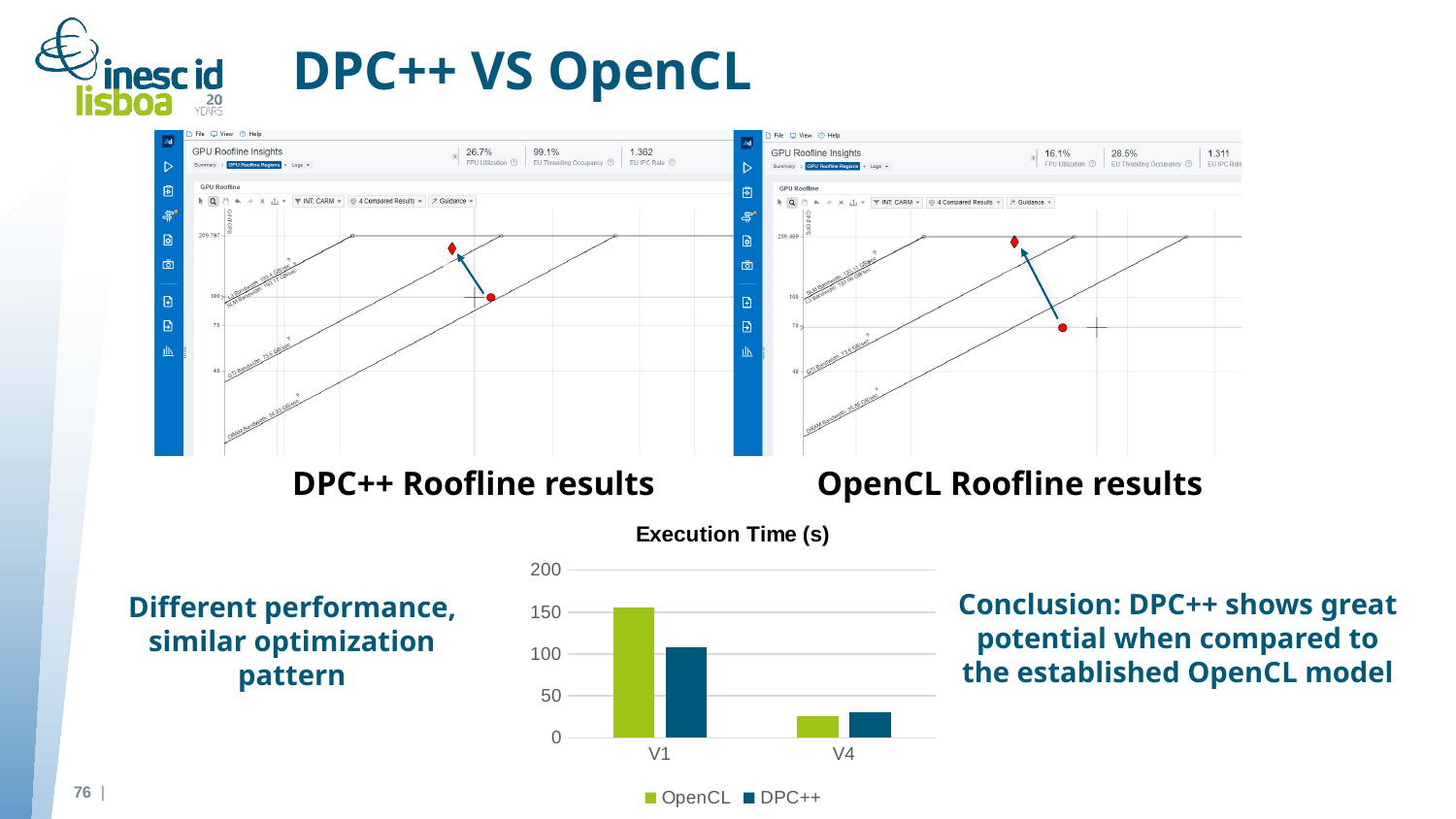
How many categories are shown on the x axis of the Execution Time (s) chart? 2 Which series are listed in the legend of the Execution Time (s) chart? OpenCL and DPC++ In the Execution Time (s) chart, is the OpenCL value for V4 greater or less than 50? less In the Execution Time (s) chart, which series has the larger value for V1, OpenCL or DPC++? OpenCL What type of chart is the Execution Time (s) chart? bar chart In the Execution Time (s) chart, is the DPC++ value for V1 greater or less than 150? less In the Execution Time (s) chart, do the OpenCL values rise or fall from V1 to V4? fall In the Execution Time (s) chart, is the OpenCL value for V1 greater or less than 100? greater In the Execution Time (s) chart, which bar is the highest overall? OpenCL for V1 What is the title of the bar chart at the bottom of the slide? Execution Time (s) How many series does the legend of the Execution Time (s) chart list? 2